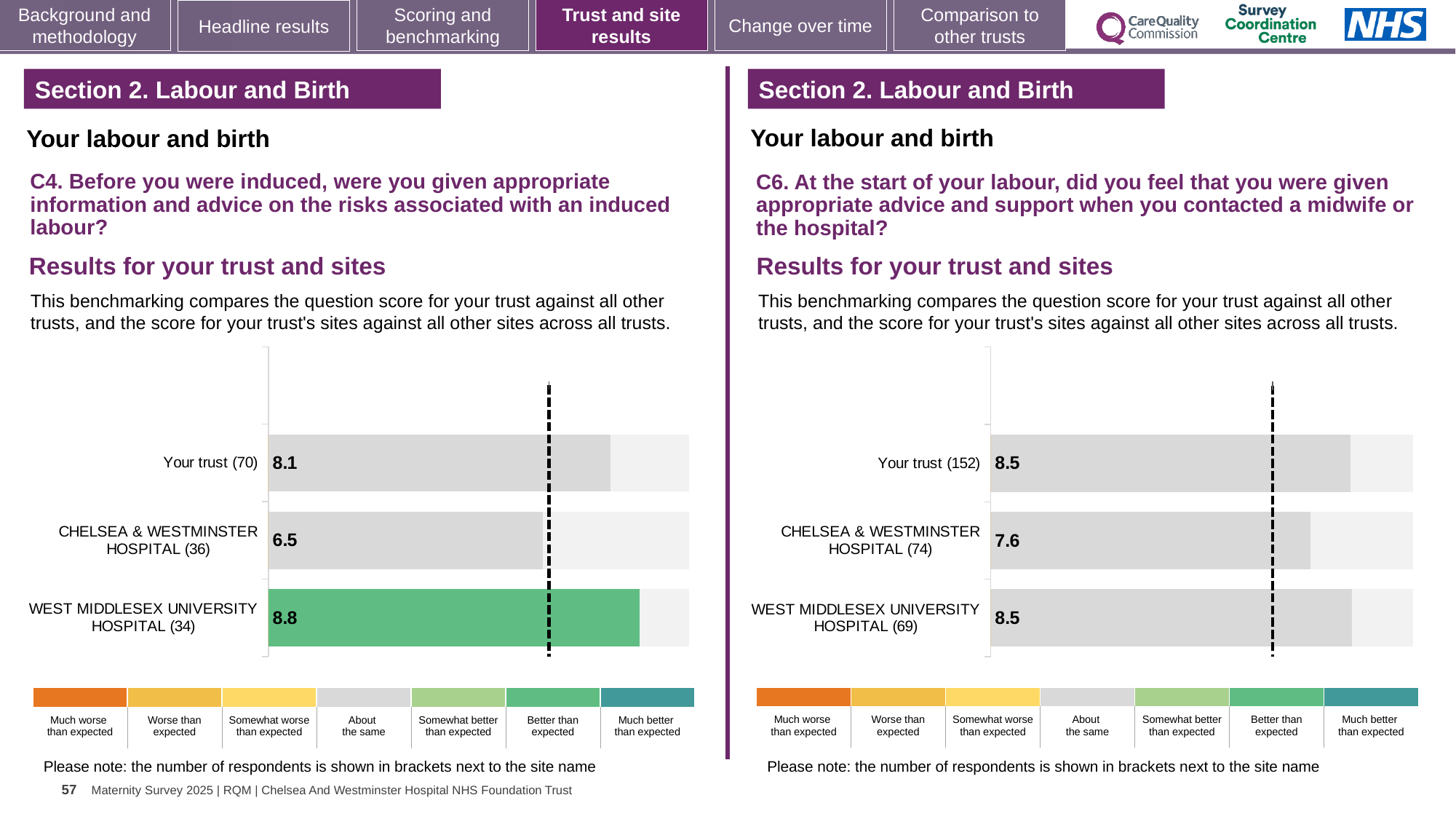
In the C6 chart on the right, which has the larger score: CHELSEA & WESTMINSTER HOSPITAL (74) or WEST MIDDLESEX UNIVERSITY HOSPITAL (69)? WEST MIDDLESEX UNIVERSITY HOSPITAL (69) In the C6 chart on the right, what is the score for Your trust (152)? 8.5 In the C6 chart on the right, which site or trust has the lowest score? CHELSEA & WESTMINSTER HOSPITAL (74) In the C6 chart on the right, what is the difference between the scores for Your trust (152) and CHELSEA & WESTMINSTER HOSPITAL (74)? 0.9 In the C4 chart on the left, how many bars are plotted? 3 In the C4 chart on the left, what is the difference between the scores for WEST MIDDLESEX UNIVERSITY HOSPITAL (34) and CHELSEA & WESTMINSTER HOSPITAL (36)? 2.3 In the C4 chart on the left, what is the score for CHELSEA & WESTMINSTER HOSPITAL (36)? 6.5 In the C4 chart on the left, what is the score for Your trust (70)? 8.1 In the C4 chart on the left, which site or trust has the highest score? WEST MIDDLESEX UNIVERSITY HOSPITAL (34) In the C6 chart on the right, what is the score for CHELSEA & WESTMINSTER HOSPITAL (74)? 7.6 In the C4 chart on the left, which benchmarking category does the colour of the WEST MIDDLESEX UNIVERSITY HOSPITAL (34) bar indicate? Better than expected What kind of chart is used in the C6 chart on the right? Bar chart